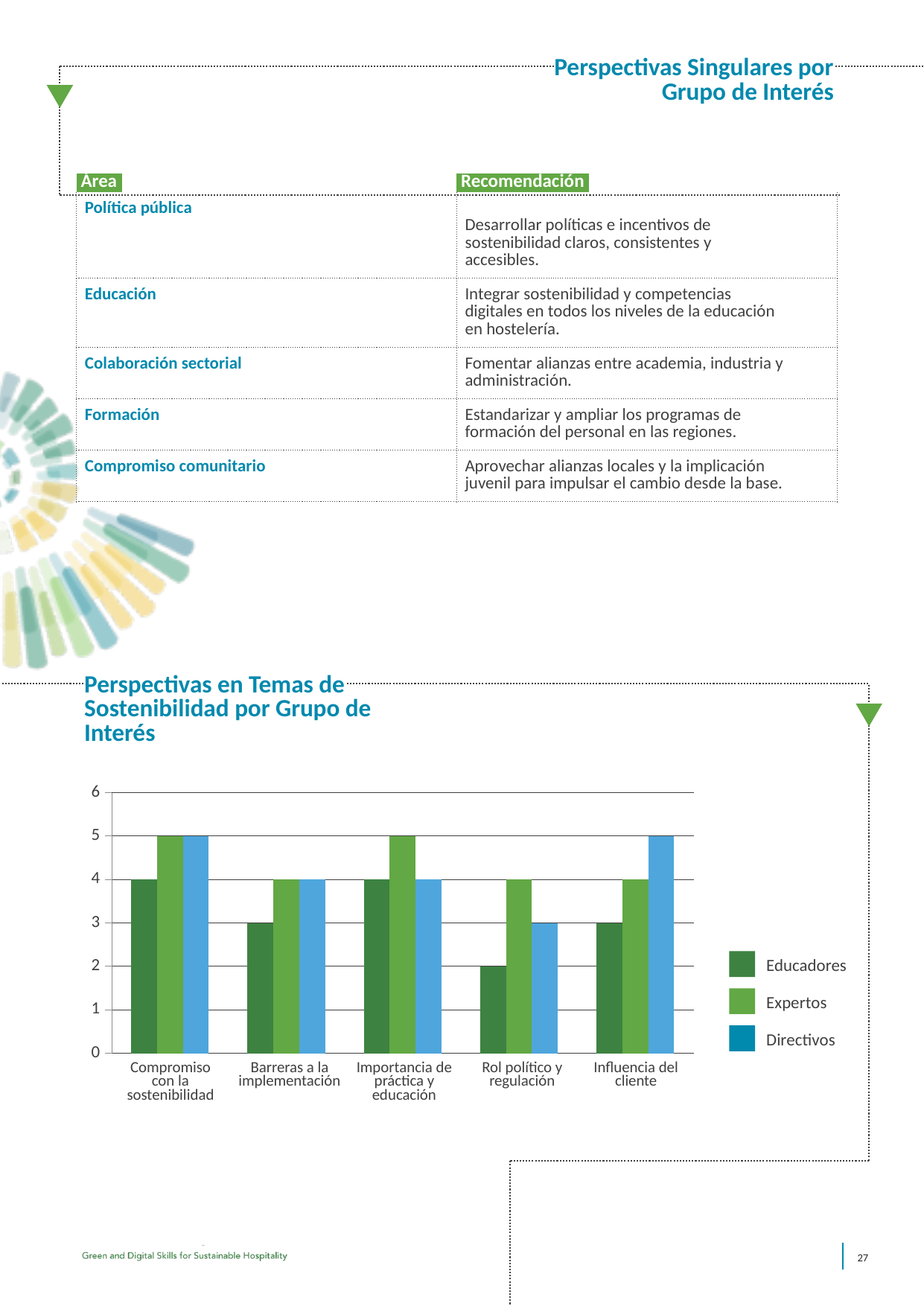
In which category does the Educadores series have its lowest value? Rol político y regulación Which series is shown in light blue in the chart legend? Directivos How many series does the chart legend list? 3 Is the value for Educadores in 'Rol político y regulación' greater or less than 3? less What kind of chart is shown under 'Perspectivas en Temas de Sostenibilidad por Grupo de Interés'? Bar chart How many categories are shown on the x axis of the chart? 5 What is the difference between the Expertos and Educadores values in the 'Rol político y regulación' category? 2 What is the value for Expertos in the 'Importancia de práctica y educación' category? 5 In which category does the Directivos series have its lowest value? Rol político y regulación In the 'Influencia del cliente' category, which is larger: the Directivos value or the Educadores value? Directivos What is the value for Educadores in the 'Rol político y regulación' category? 2 What is the value for Directivos in the 'Barreras a la implementación' category? 4